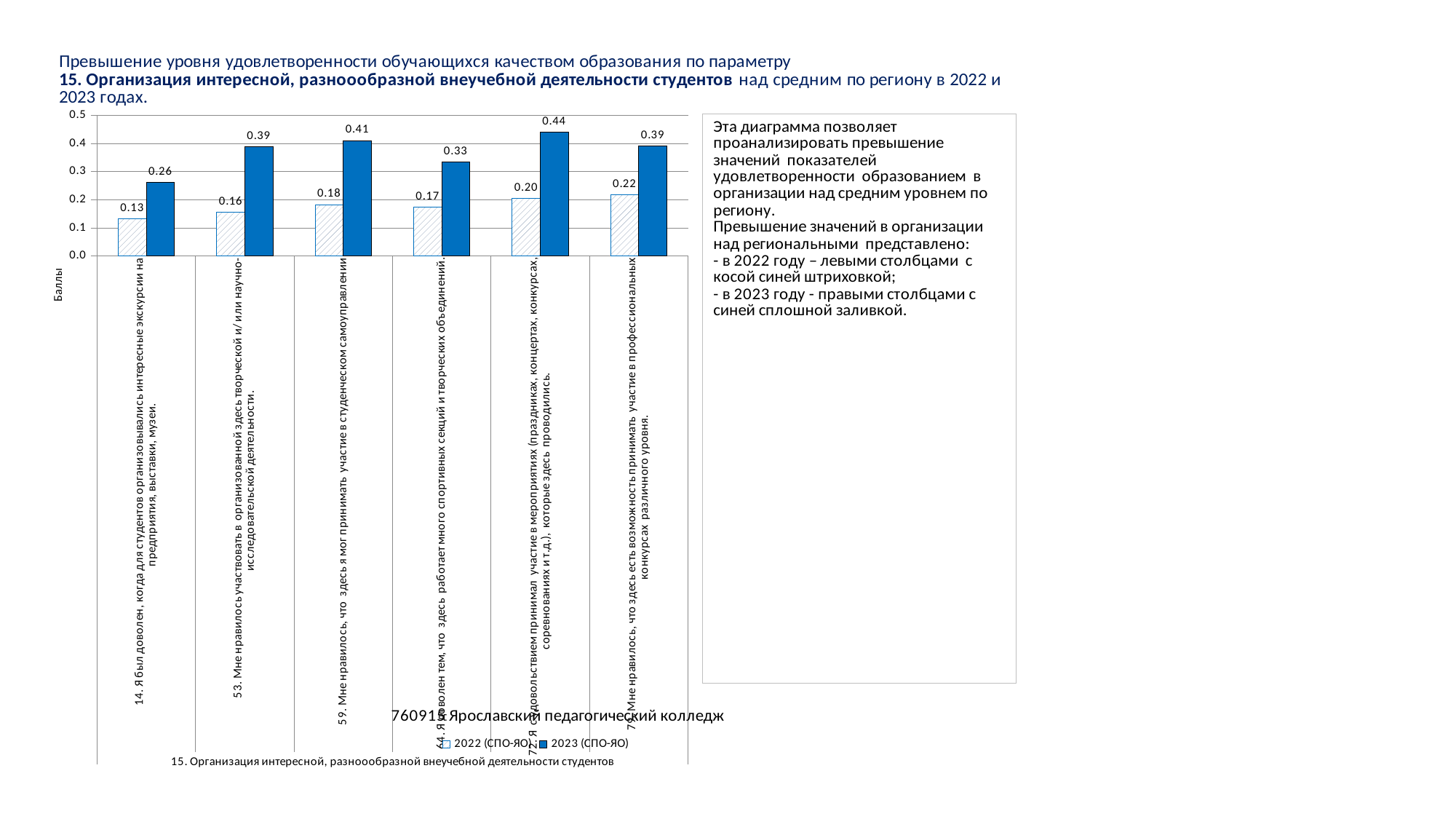
What is the 2023 (СПО-ЯО) value for category 79 (участие в профессиональных конкурсах различного уровня)? 0.39 Is the 2023 (СПО-ЯО) value for category 72 greater or less than 0.4? greater What is the label of the vertical axis of the chart? Баллы What is the 2023 (СПО-ЯО) value for category 14 (Я был доволен, когда для студентов организовывались интересные экскурсии на предприятия, выставки, музеи)? 0.26 Which category has the highest 2023 (СПО-ЯО) value? 72. Я с удовольствием принимал участие в мероприятиях (праздниках, концертах, конкурсах, соревнованиях и т.д.), которые здесь проводились. How many categories are shown on the x axis of the chart? 6 What is the difference between the 2023 and 2022 values for category 53 (участвовать в организованной здесь творческой и/или научно-исследовательской деятельности)? 0.23 How many series does the chart legend list? 2 What type of chart is shown on the slide? Bar chart Which category has the lowest 2022 (СПО-ЯО) value? 14. Я был доволен, когда для студентов организовывались интересные экскурсии на предприятия, выставки, музеи. What is the 2022 (СПО-ЯО) value for category 59 (Мне нравилось, что здесь я мог принимать участие в студенческом самоуправлении)? 0.18 Which is larger: the 2023 value for category 59 or the 2023 value for category 64? Category 59 (0.41)